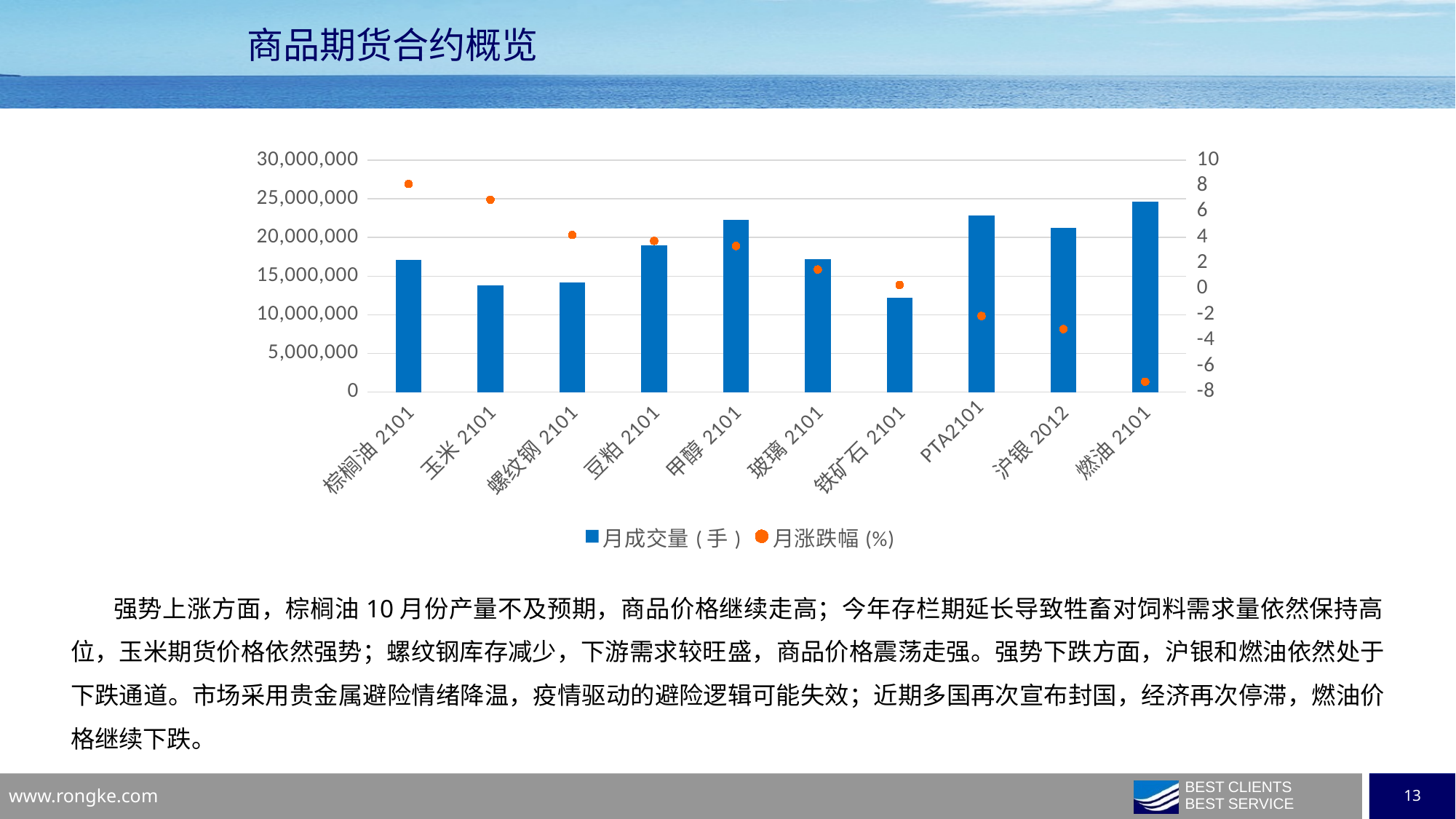
How many series does the chart legend list? 2 What kind of chart is used to plot the 月成交量（手） series? Bar chart Which contract has the lowest 月涨跌幅 (%)? 燃油 2101 Which contract has the highest 月涨跌幅 (%)? 棕榈油 2101 Is the 月成交量（手） for 燃油 2101 greater or less than 20,000,000? greater Which contract has the lowest 月成交量（手）? 铁矿石 2101 Is the 月涨跌幅 (%) for 棕榈油 2101 greater or less than 6? greater How many categories (contracts) are shown on the x axis of the chart? 10 Which has the larger 月成交量（手）, 甲醇 2101 or 玻璃 2101? 甲醇 2101 Is the 月成交量（手） for 铁矿石 2101 greater or less than 15,000,000? less Which contract has the highest 月成交量（手）? 燃油 2101 Does the 月涨跌幅 (%) series generally rise or fall moving from left to right along the x axis? Fall